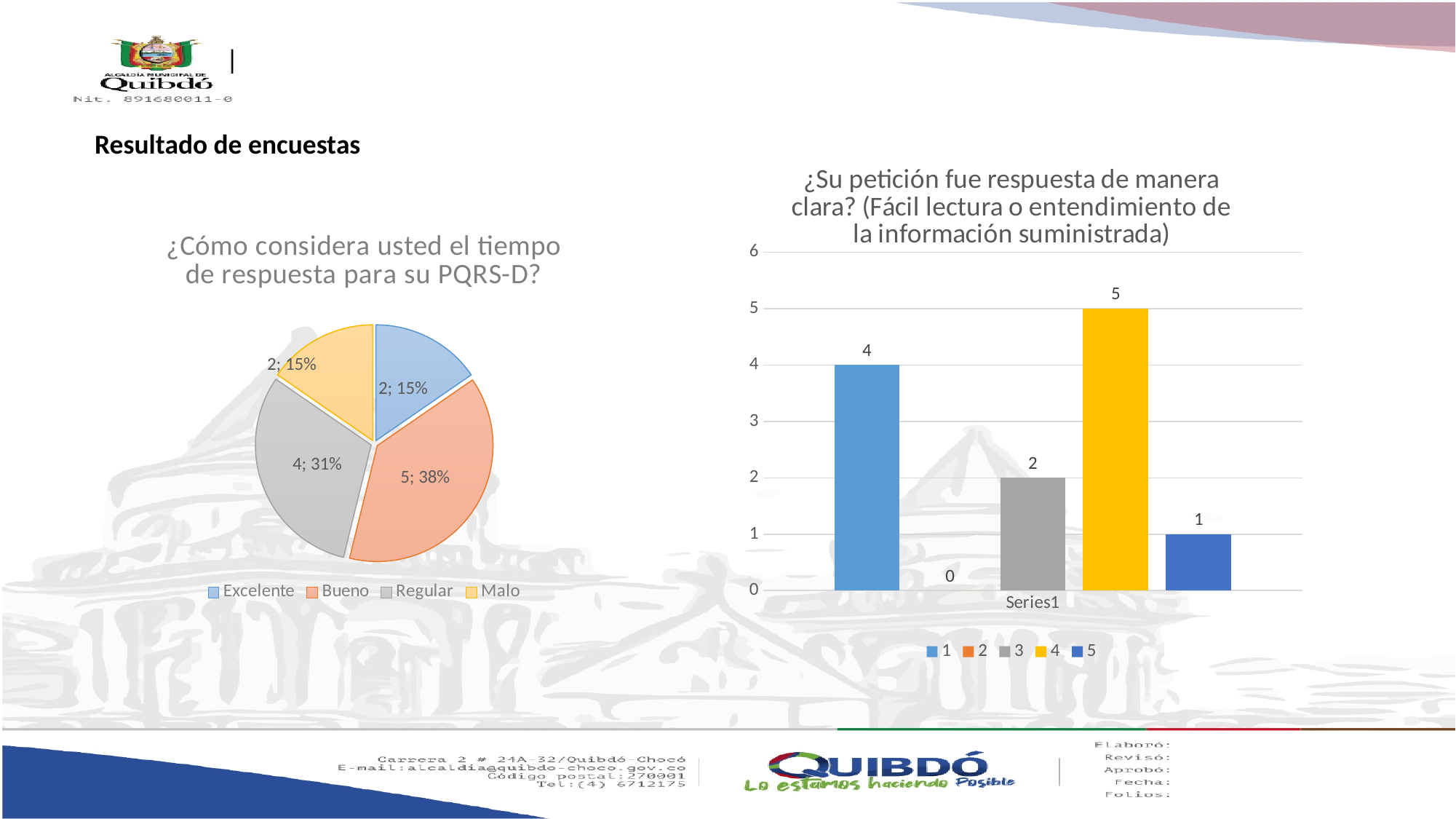
In the pie chart '¿Cómo considera usted el tiempo de respuesta para su PQRS-D?', what share does Malo have? 15% In the bar chart '¿Su petición fue respuesta de manera clara?', which series has the lowest value? 2 In the pie chart '¿Cómo considera usted el tiempo de respuesta para su PQRS-D?', which category has the largest slice? Bueno In the bar chart '¿Su petición fue respuesta de manera clara?', how many series does the legend list? 5 In the pie chart '¿Cómo considera usted el tiempo de respuesta para su PQRS-D?', how many categories does the legend list? 4 In the bar chart '¿Su petición fue respuesta de manera clara?', what is the difference between the values for series 4 and series 1? 1 In the pie chart '¿Cómo considera usted el tiempo de respuesta para su PQRS-D?', what share does Bueno have? 38% What kind of chart is the chart on the right side of the slide? Bar chart In the bar chart '¿Su petición fue respuesta de manera clara?', which series has the highest value? 4 In the bar chart '¿Su petición fue respuesta de manera clara?', what is the value for series 4? 5 In the bar chart '¿Su petición fue respuesta de manera clara?', what is the value for series 2? 0 In the pie chart '¿Cómo considera usted el tiempo de respuesta para su PQRS-D?', what is the count shown for Regular? 4